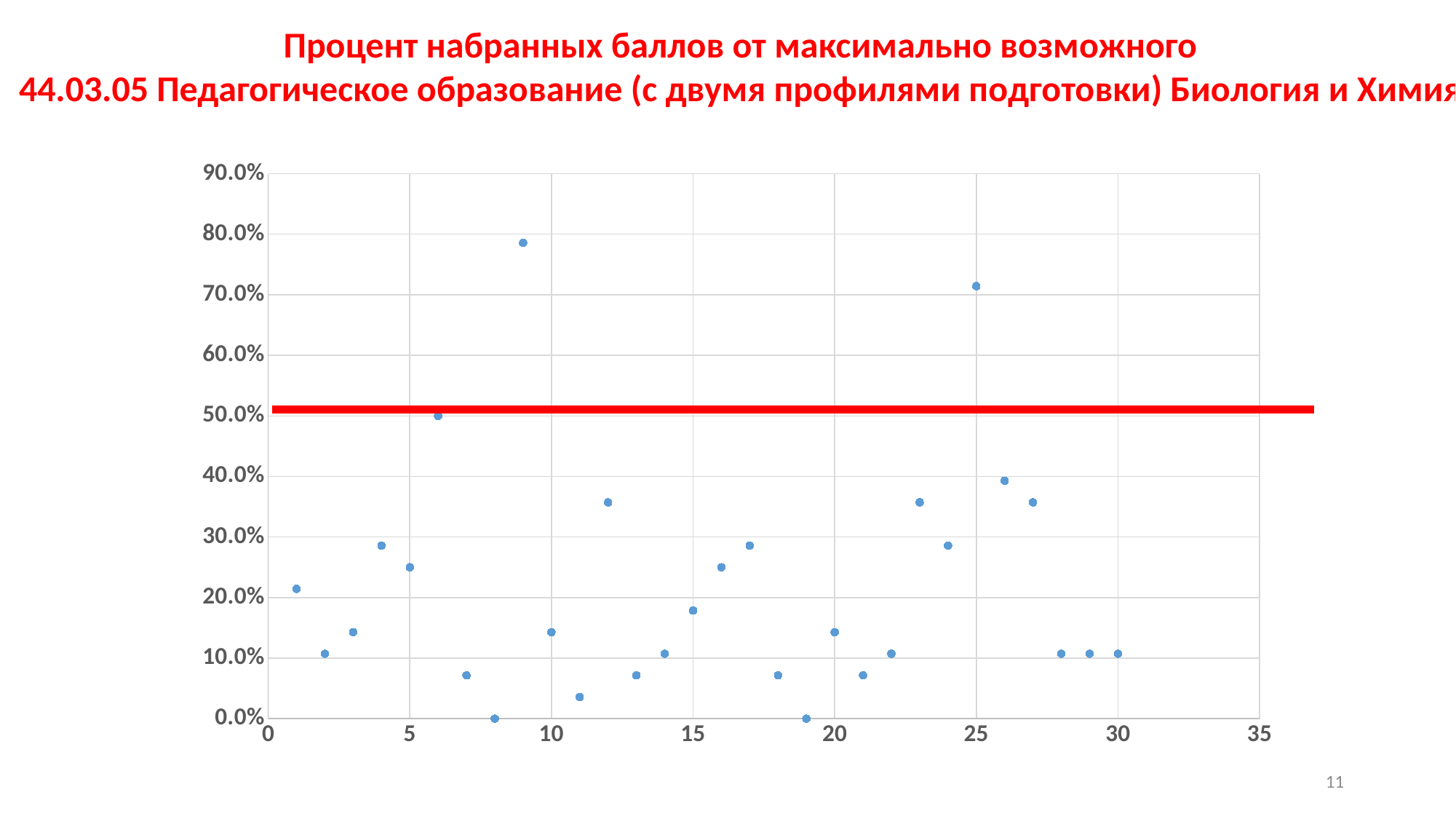
Is the value of the point at x = 25 greater or less than 60.0%? greater What kind of chart is shown on the slide? scatter chart Is the value of the point at x = 9 greater or less than 70.0%? greater At which x value does the highest point on the chart occur? 9 Which point has the larger value, the one at x = 9 or the one at x = 25? x = 9 How many data points are plotted on the chart? 30 How many points on the chart have a value of 0.0%? 2 Is the value of the point at x = 12 greater or less than 30.0%? greater What is the value of the point at x = 19? 0.0% What is the value of the point at x = 8? 0.0%